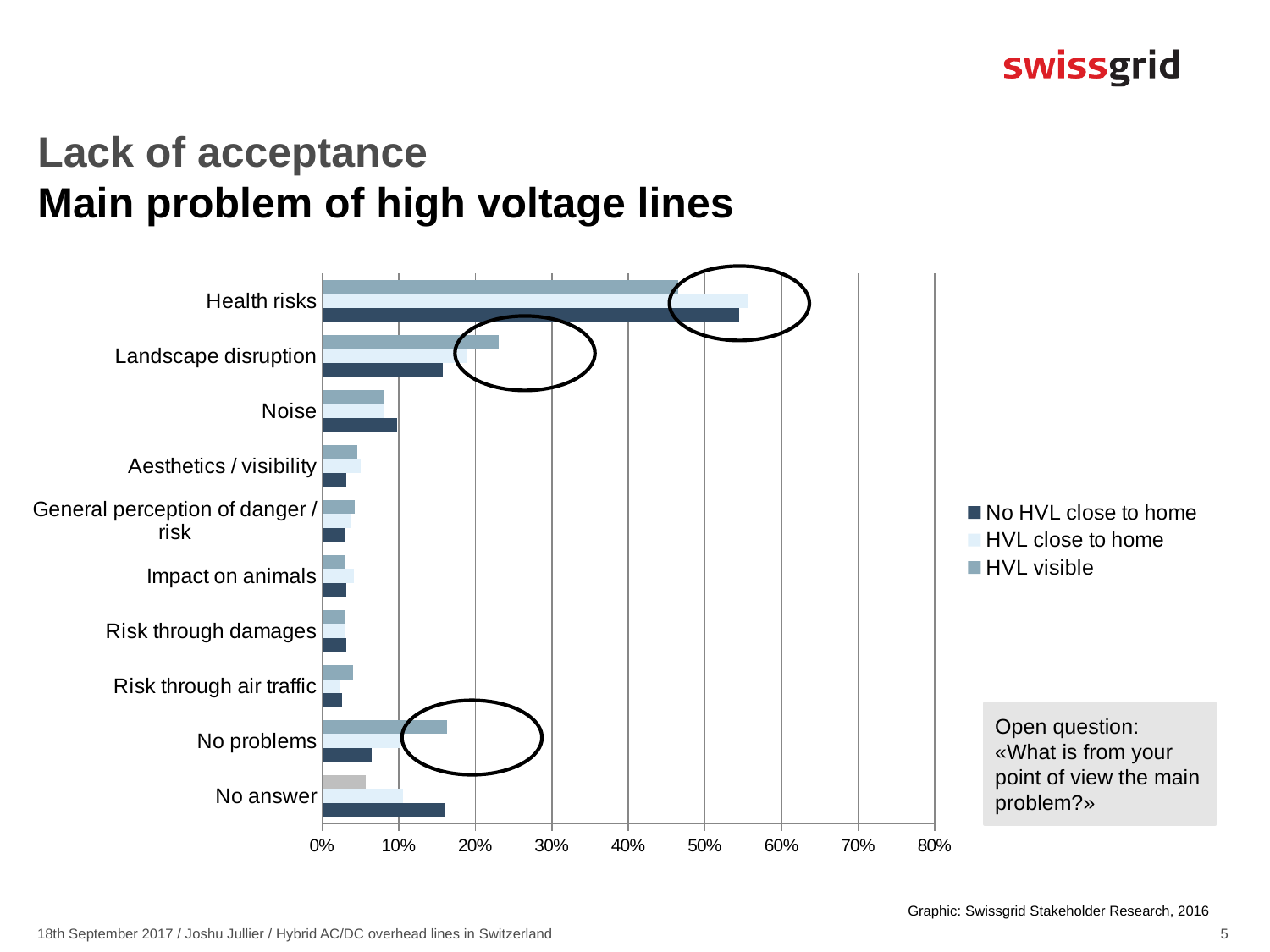
Is the value for No problems in the 'HVL visible' series greater or less than 10%? greater For the 'HVL visible' series, which is larger: Health risks or Landscape disruption? Health risks How many series does the legend list? 3 Which category has the highest value for the 'HVL visible' series? Health risks Is the value for Health risks in the 'HVL visible' series greater or less than 50%? less How many categories are plotted on the chart? 10 What is the title of the chart on the slide? Main problem of high voltage lines What kind of chart is shown on the slide? bar chart Which category has the highest value for the 'HVL close to home' series? Health risks Is the value for Landscape disruption in the 'No HVL close to home' series greater or less than 20%? less